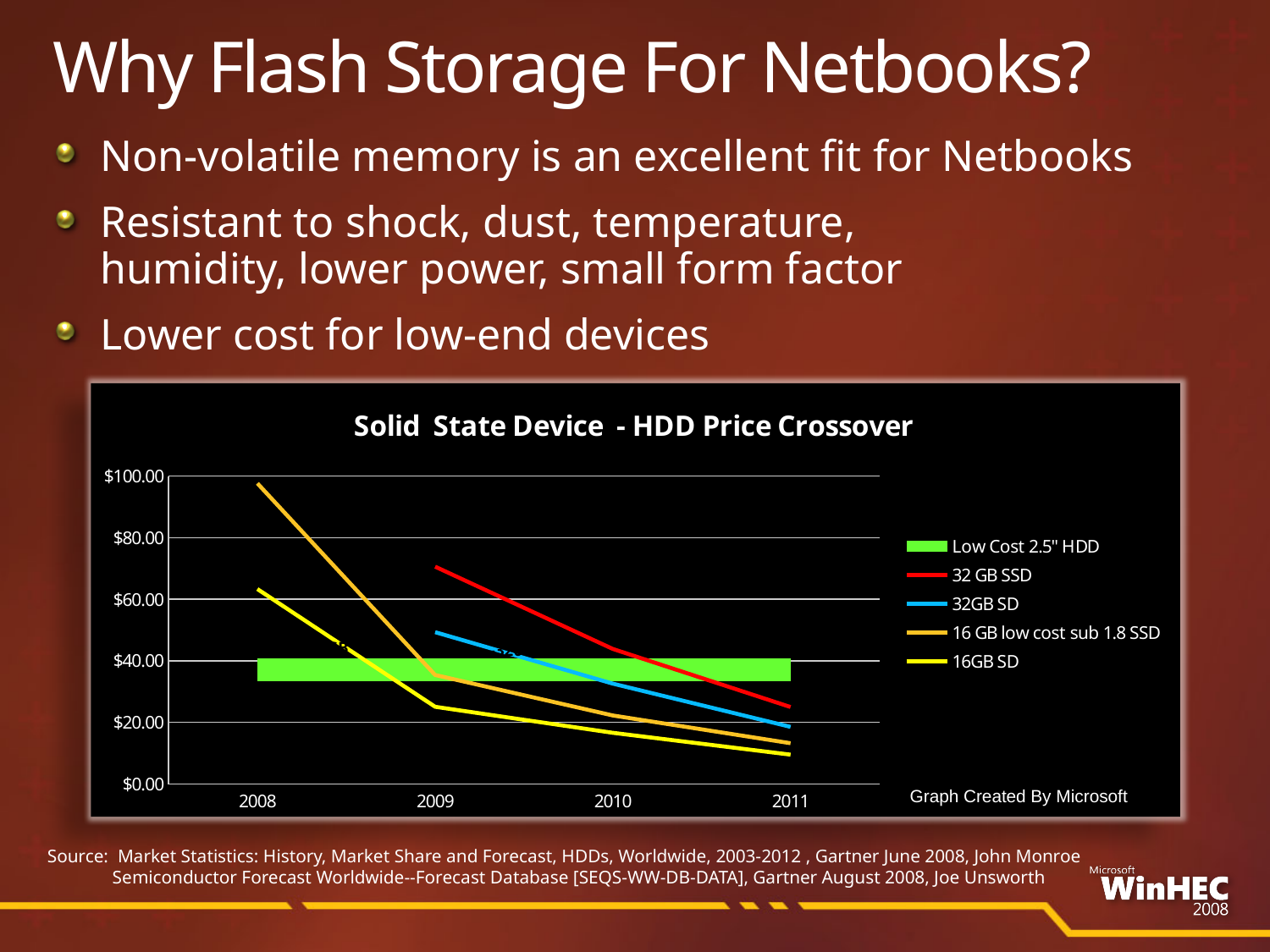
What colour is the 32 GB SSD line in the chart? red What kind of chart is shown on the slide? line chart What is the title of the chart? Solid State Device - HDD Price Crossover Is the value for 32GB SD in 2009 greater or less than $40.00? greater Which series has the lowest value in 2011? 16GB SD Is the value for 32 GB SSD in 2011 greater or less than $40.00? less How many years are shown on the x axis of the chart? 4 How many series does the chart's legend list? 5 In 2009, which is higher: 32 GB SSD or 32GB SD? 32 GB SSD Does the 16GB SD line rise or fall from 2008 to 2011? fall Which series has the highest value in 2008? 16 GB low cost sub 1.8 SSD Is the value for 16 GB low cost sub 1.8 SSD in 2008 greater or less than $80.00? greater